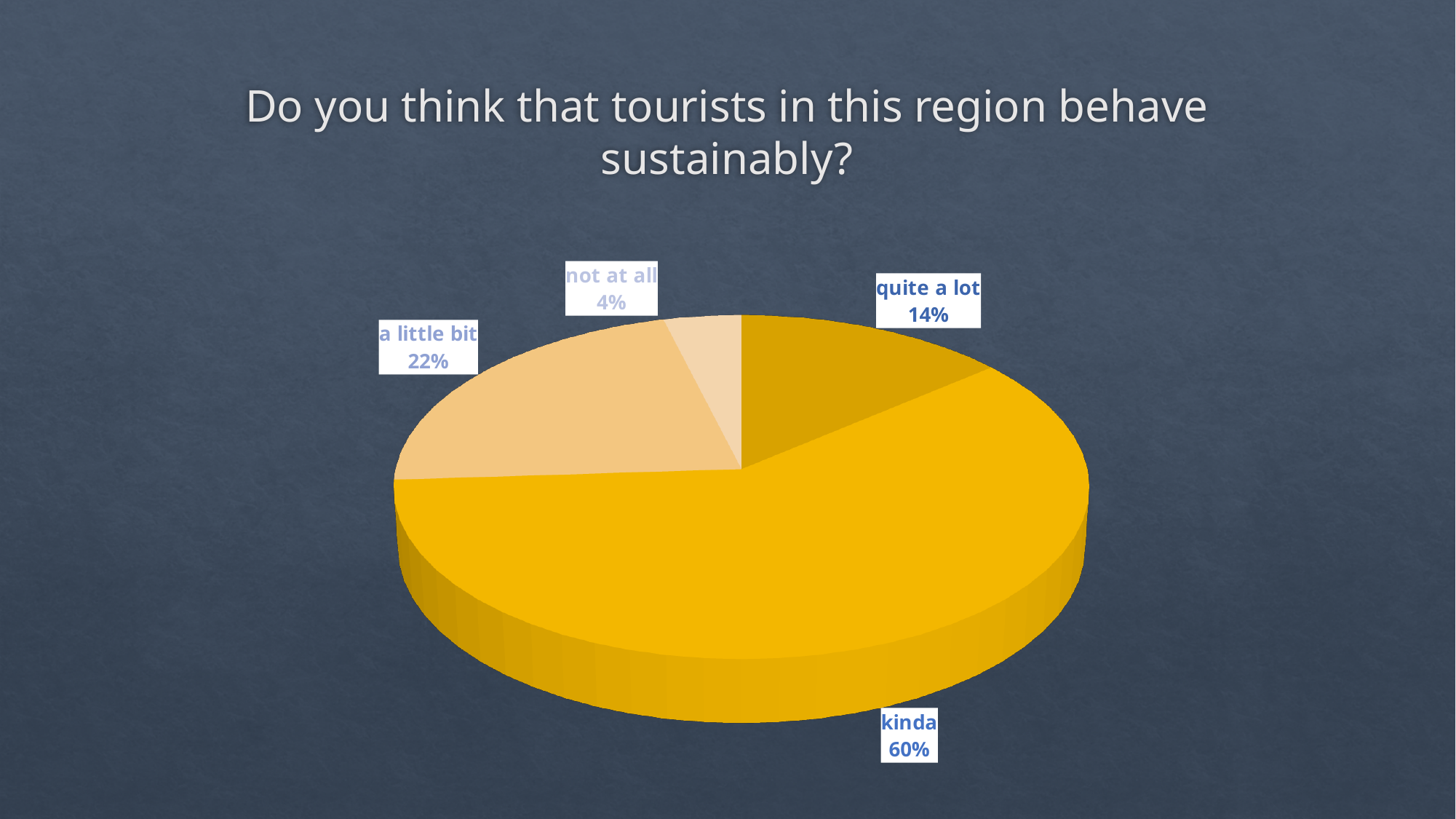
What is the title of the chart? Do you think that tourists in this region behave sustainably? What is the difference in percentage points between "a little bit" and "quite a lot"? 8 Which response has the largest share of the pie? kinda What kind of chart is shown on the slide? pie chart What percentage of respondents answered "a little bit"? 22% Which is larger, the share for "a little bit" or the share for "quite a lot"? a little bit What percentage of respondents answered "not at all"? 4% What is the difference in percentage points between "kinda" and "not at all"? 56 What percentage of respondents answered "quite a lot"? 14% Which response has the smallest share of the pie? not at all What percentage of respondents answered "kinda"? 60% How many slices does the pie chart have? 4